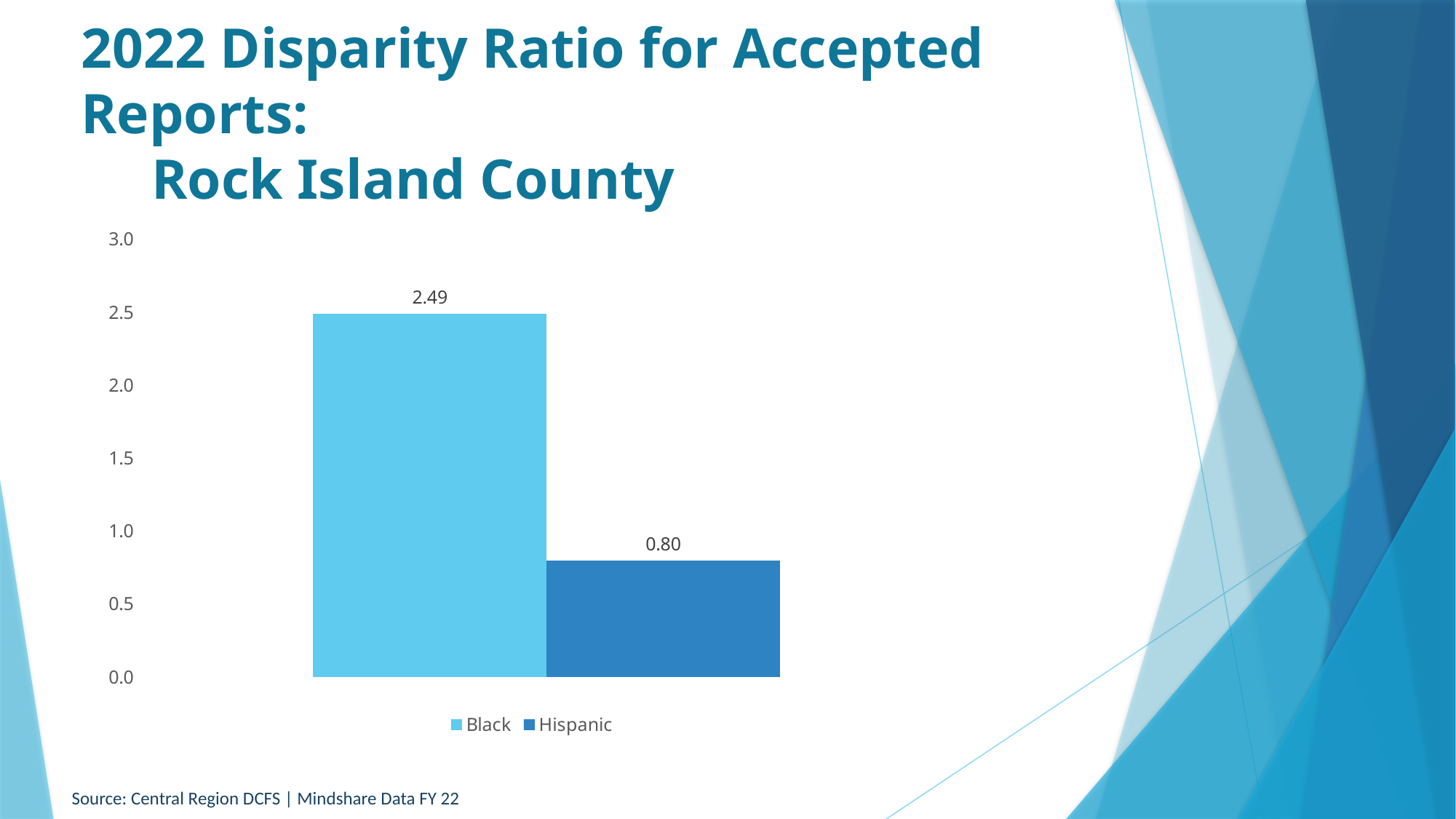
Is the disparity ratio for Hispanic greater or less than 1.0? less What is the highest value shown on the vertical axis? 3.0 Which group has the higher disparity ratio? Black Which legend entry is shown in the lighter blue colour? Black How many series does the legend list? 2 Is the disparity ratio for Black greater or less than 2.0? greater What kind of chart is shown on the slide? Bar chart Which group has the lower disparity ratio? Hispanic What is the difference between the Black and Hispanic disparity ratios? 1.69 What is the disparity ratio for Hispanic in the chart? 0.80 What is the disparity ratio for Black in the chart? 2.49 Is the value for Hispanic larger than the value for Black? No